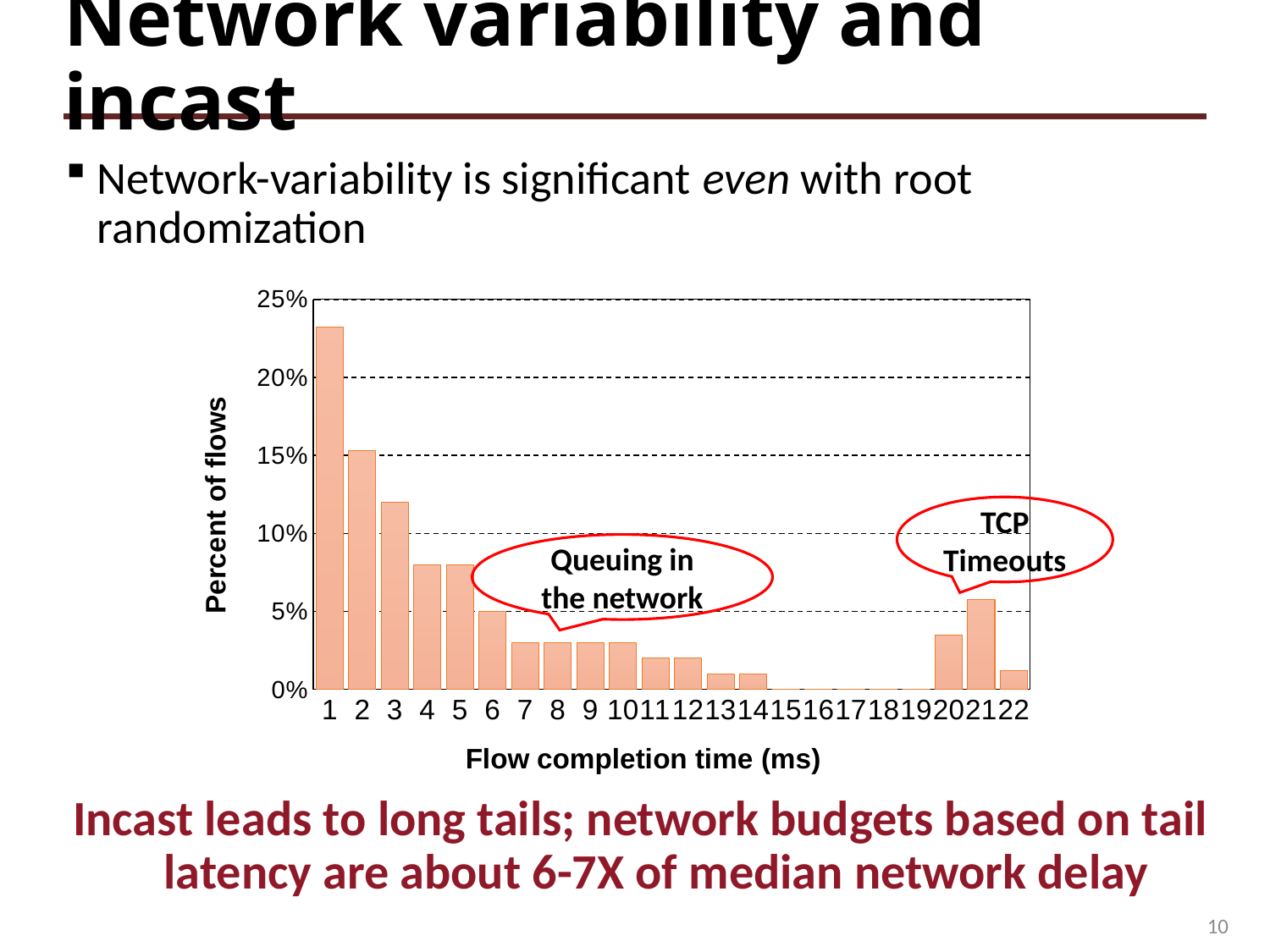
Which has a higher percent of flows, flow completion time 20 or flow completion time 21? 21 Which flow completion time has the highest percent of flows? 1 Is the percent of flows for flow completion time 3 greater or less than 10%? greater What is the label of the x axis? Flow completion time (ms) Which has a higher percent of flows, flow completion time 1 or flow completion time 2? 1 What kind of chart is shown on the slide? bar chart Is the percent of flows for flow completion time 1 greater or less than 20%? greater How many flow completion time categories are shown on the x axis? 22 Is the percent of flows for flow completion time 4 greater or less than 10%? less Do the percent of flows values rise or fall from flow completion time 1 to 6? fall